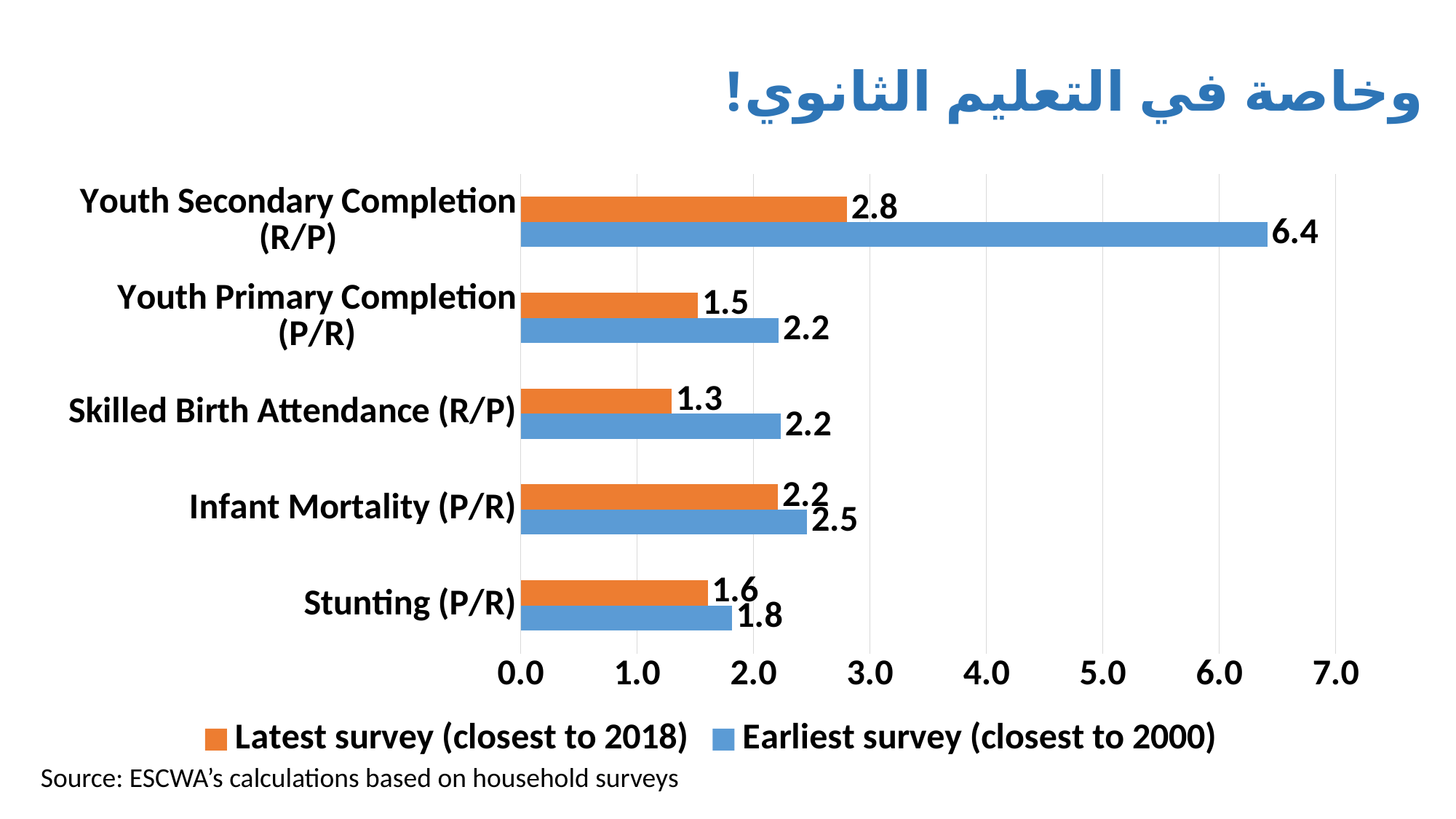
Which category has the highest Earliest survey (closest to 2000) value? Youth Secondary Completion (R/P) What is the difference between the Earliest survey and Latest survey values for Youth Primary Completion (P/R)? 0.7 What is the Latest survey (closest to 2018) value for Infant Mortality (P/R)? 2.2 Which category has the lowest Latest survey (closest to 2018) value? Skilled Birth Attendance (R/P) How many categories are shown on the chart? 5 What is the Latest survey (closest to 2018) value for Skilled Birth Attendance (R/P)? 1.3 For Stunting (P/R), which is larger: the Latest survey value or the Earliest survey value? Earliest survey (closest to 2000) What kind of chart is shown on the slide? Bar chart What is the Earliest survey (closest to 2000) value for Youth Secondary Completion (R/P)? 6.4 What is the difference between the Earliest survey and Latest survey values for Youth Secondary Completion (R/P)? 3.6 Is the Earliest survey (closest to 2000) value for Youth Secondary Completion (R/P) greater or less than 6.0? greater How many series does the legend list? 2